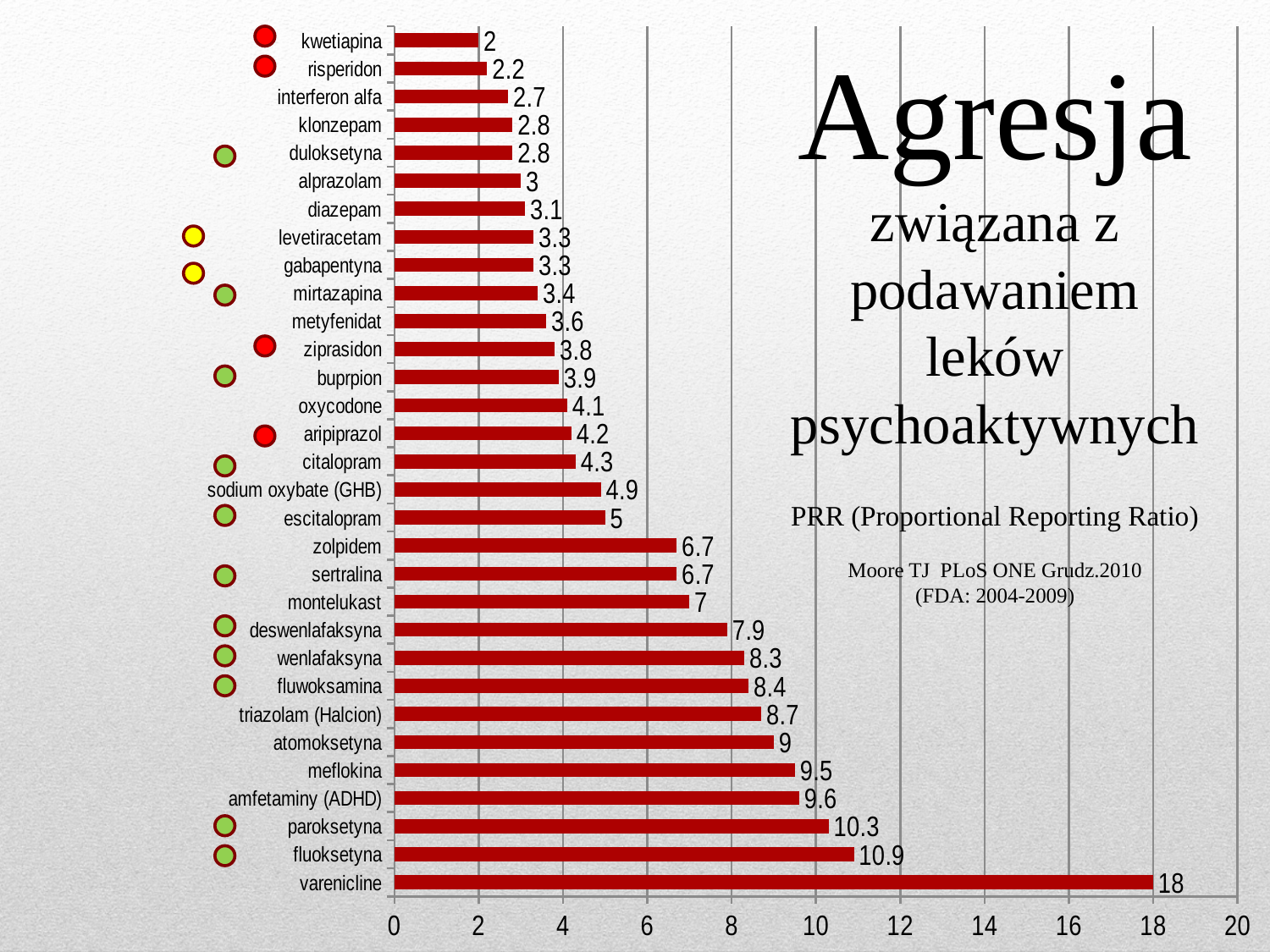
What is the difference between the PRR values for paroksetyna and atomoksetyna? 1.3 What is the PRR value for sodium oxybate (GHB)? 4.9 What is the maximum value shown on the horizontal axis? 20 What is the difference between the PRR values for varenicline and fluoksetyna? 7.1 What type of chart is shown on the slide? bar chart What is the PRR value for fluoksetyna? 10.9 Which drug has the lowest PRR value? kwetiapina Which has a higher PRR value, meflokina or montelukast? meflokina Which drug has the highest PRR value? varenicline How many drugs are listed in the chart? 31 What is the PRR value for varenicline? 18 What is the PRR value for kwetiapina? 2